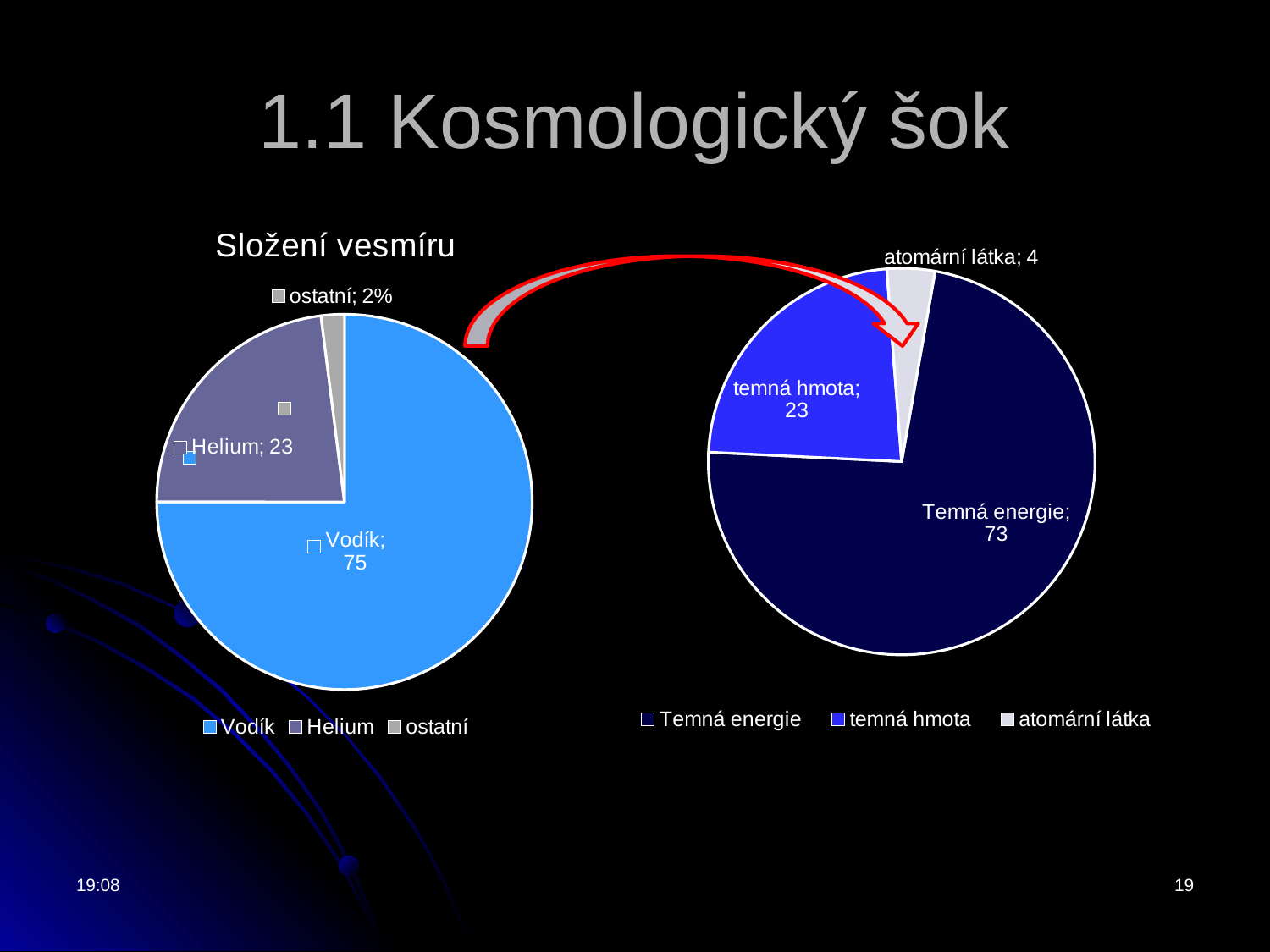
In the chart titled "Složení vesmíru", what is the value for Vodík? 75 In the chart titled "Složení vesmíru", what is the difference between the values for Vodík and Helium? 52 In the chart titled "Složení vesmíru", how many categories does the legend list? 3 What type of chart is the right-hand chart on the slide? Pie chart In the right-hand pie chart, what is the difference between the values for Temná energie and temná hmota? 50 In the chart titled "Složení vesmíru", which category has the largest slice? Vodík In the right-hand pie chart, which is larger, temná hmota or atomární látka? temná hmota In the chart titled "Složení vesmíru", which category has the smallest slice? ostatní In the chart titled "Složení vesmíru", what is the value for Helium? 23 In the right-hand pie chart, what is the value for atomární látka? 4 In the right-hand pie chart, what is the value for Temná energie? 73 In the chart titled "Složení vesmíru", what is the value shown for ostatní? 2%